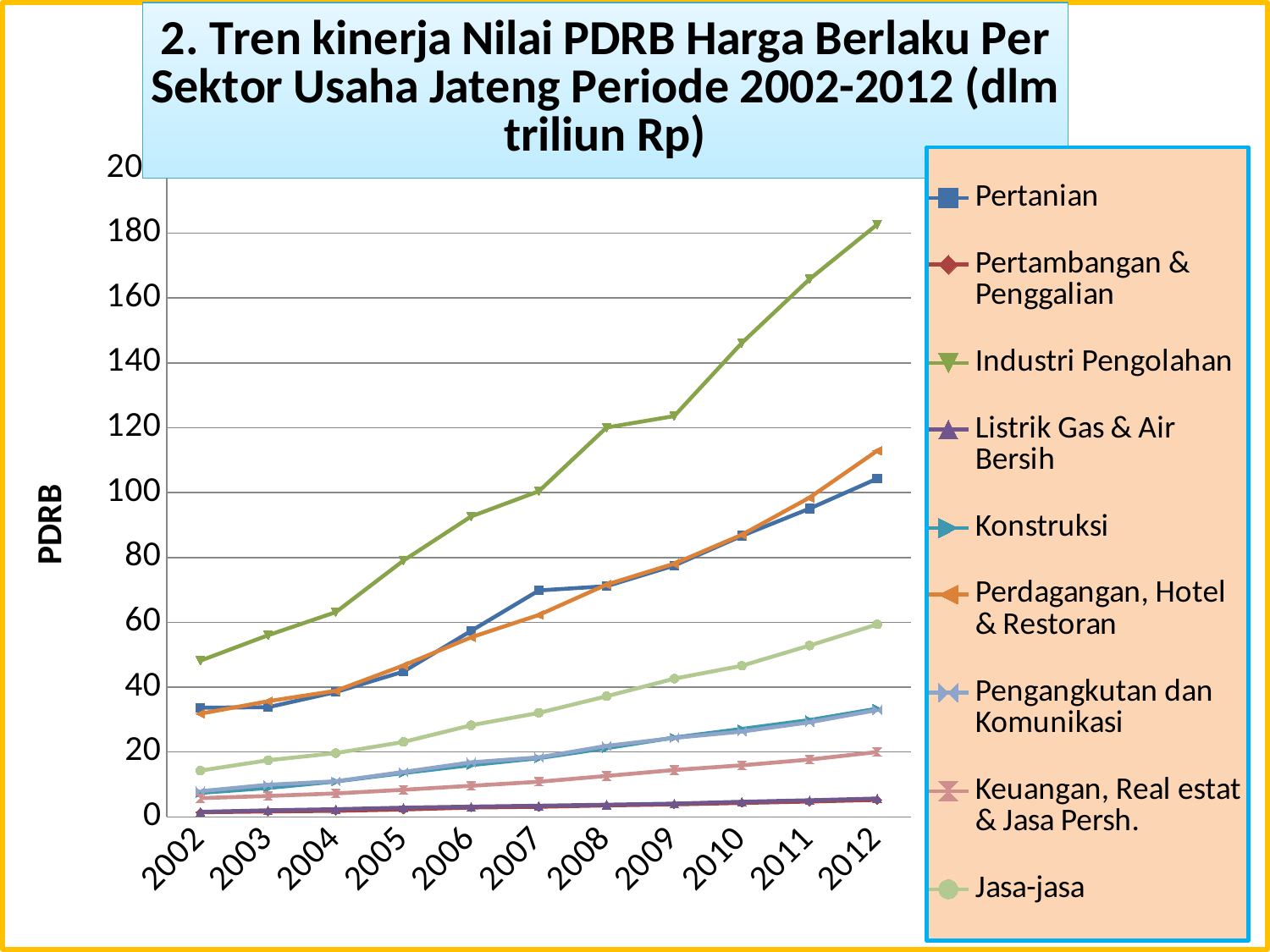
What is the label on the y axis? PDRB Which is larger in 2012, Jasa-jasa or Konstruksi? Jasa-jasa Is the value for Industri Pengolahan in 2002 greater or less than 40? greater What kind of chart is shown on the slide? line chart How many years are plotted along the x axis? 11 Is the value for Industri Pengolahan in 2012 greater or less than 160? greater How many series does the legend list? 9 Which is larger in 2012, Industri Pengolahan or Pertanian? Industri Pengolahan Is the value for Pertanian in 2012 greater or less than 100? greater Which sector has the highest PDRB value in 2012? Industri Pengolahan Does the value for Industri Pengolahan rise or fall from 2002 to 2012? rise